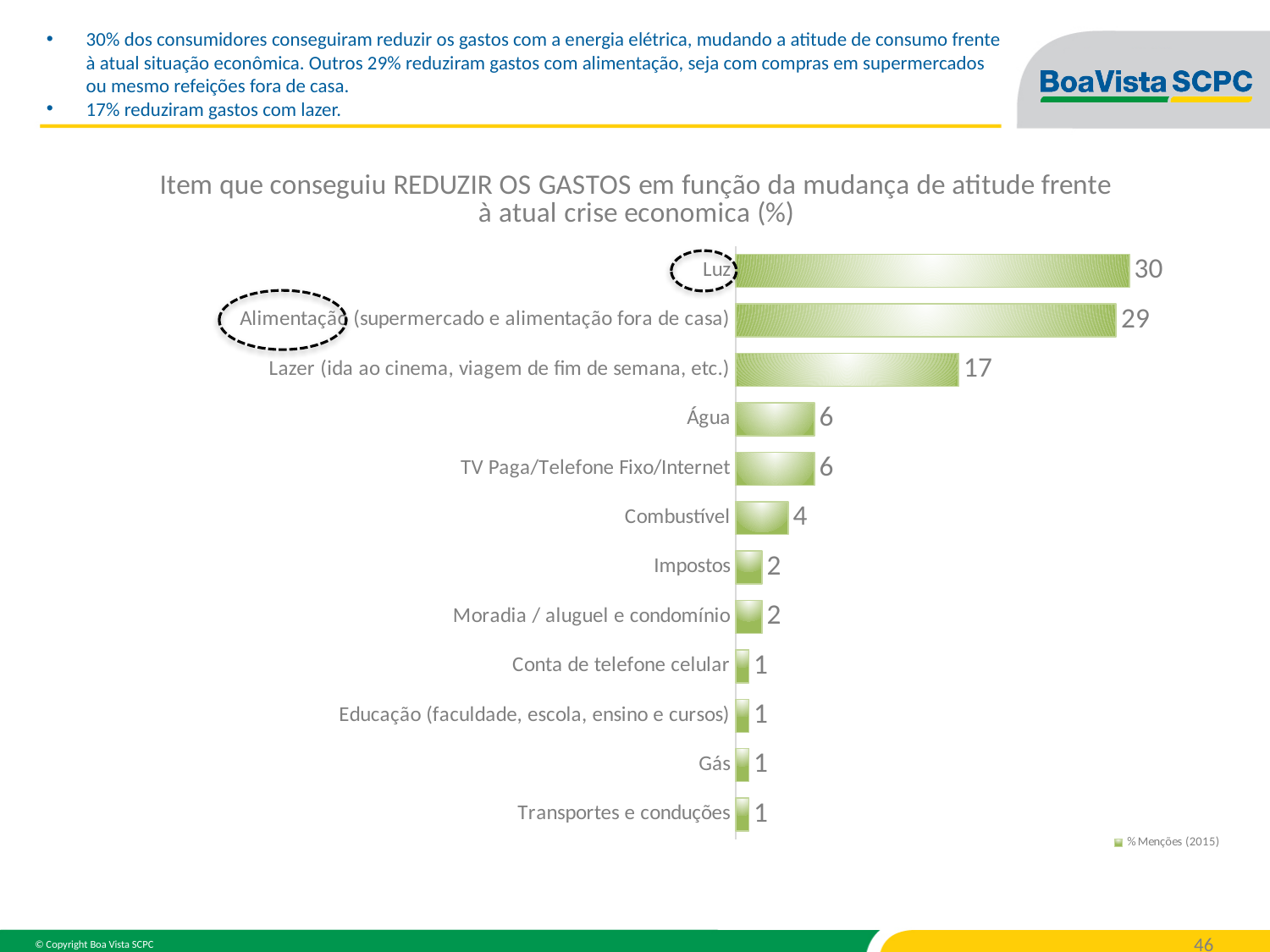
How many series does the legend list? 1 What is the difference between the values for Alimentação (supermercado e alimentação fora de casa) and Água? 23 Which is larger, the value for Água or the value for Combustível? Água Which category has the highest value? Luz What kind of chart is shown? Bar chart What is the value for Luz? 30 What is the value for Moradia / aluguel e condomínio? 2 What is the value for Combustível? 4 How many categories are shown in the chart? 12 What is the legend entry for the series shown? % Menções (2015) What is the value for Lazer (ida ao cinema, viagem de fim de semana, etc.)? 17 What is the difference between the values for Luz and Lazer (ida ao cinema, viagem de fim de semana, etc.)? 13